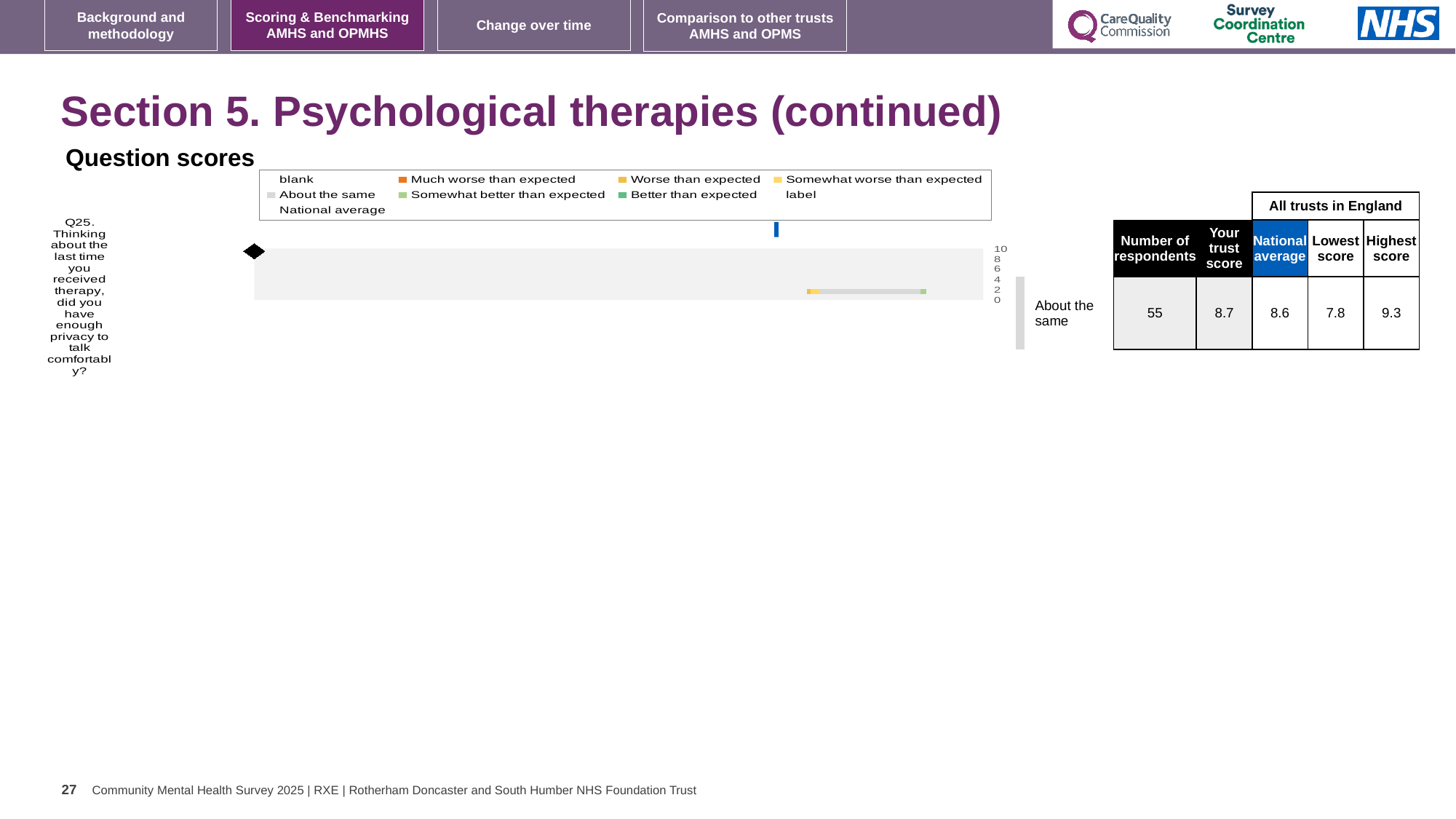
How many survey questions are plotted in the chart? 1 How many entries does the chart legend list? 9 In the table next to the chart, what is the national average for Q25? 8.6 Which question is plotted in the chart? Q25. Thinking about the last time you received therapy, did you have enough privacy to talk comfortably? In the table next to the chart, what is the highest score among all trusts in England for Q25? 9.3 In the table next to the chart, what is the number of respondents for Q25? 55 In the table next to the chart, what is the lowest score among all trusts in England for Q25? 7.8 What kind of chart is shown under 'Question scores'? bar chart What is the highest value shown on the chart's axis? 10 What benchmark category is shown to the right of the chart for Q25? About the same In the table next to the chart, what is the trust's score for Q25? 8.7 In the table next to the chart, which is larger for Q25: the trust's score or the national average? Your trust score